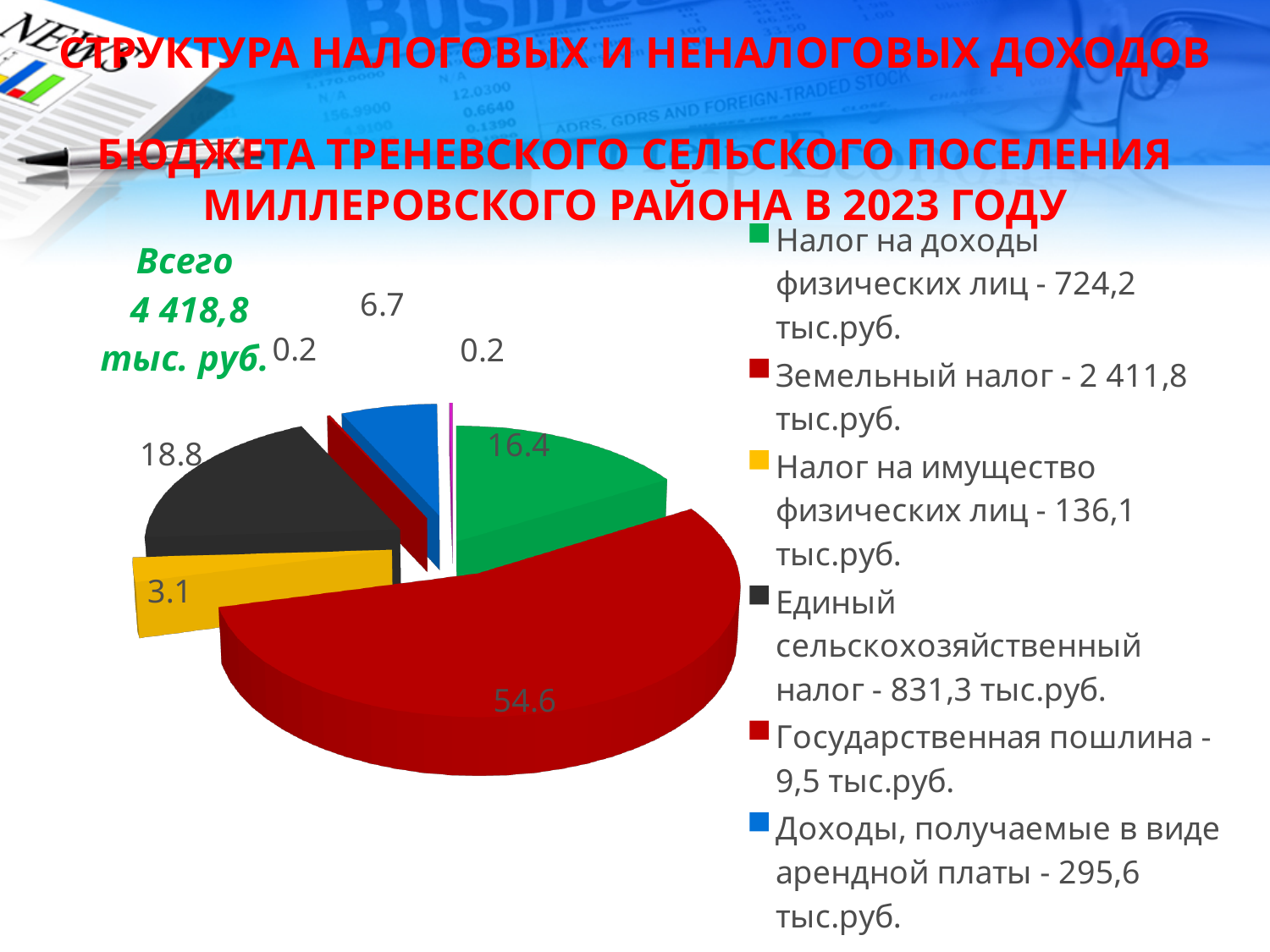
What is the data label on the slice for Земельный налог? 54.6 What is the difference between the data labels for Земельный налог and Единый сельскохозяйственный налог? 35.8 Which slice is larger: Единый сельскохозяйственный налог or Налог на доходы физических лиц? Единый сельскохозяйственный налог According to the legend, what is the amount for Земельный налог? 2 411,8 тыс.руб. What total amount (Всего) is stated next to the chart? 4 418,8 тыс. руб. What is the data label on the slice for Единый сельскохозяйственный налог? 18.8 How many slices with data labels does the pie chart have? 7 What is the data label on the slice for Доходы, получаемые в виде арендной платы? 6.7 What kind of chart is shown on the slide? pie chart What is the data label on the slice for Налог на имущество физических лиц? 3.1 What is the data label on the slice for Налог на доходы физических лиц? 16.4 Which category has the largest slice of the pie? Земельный налог